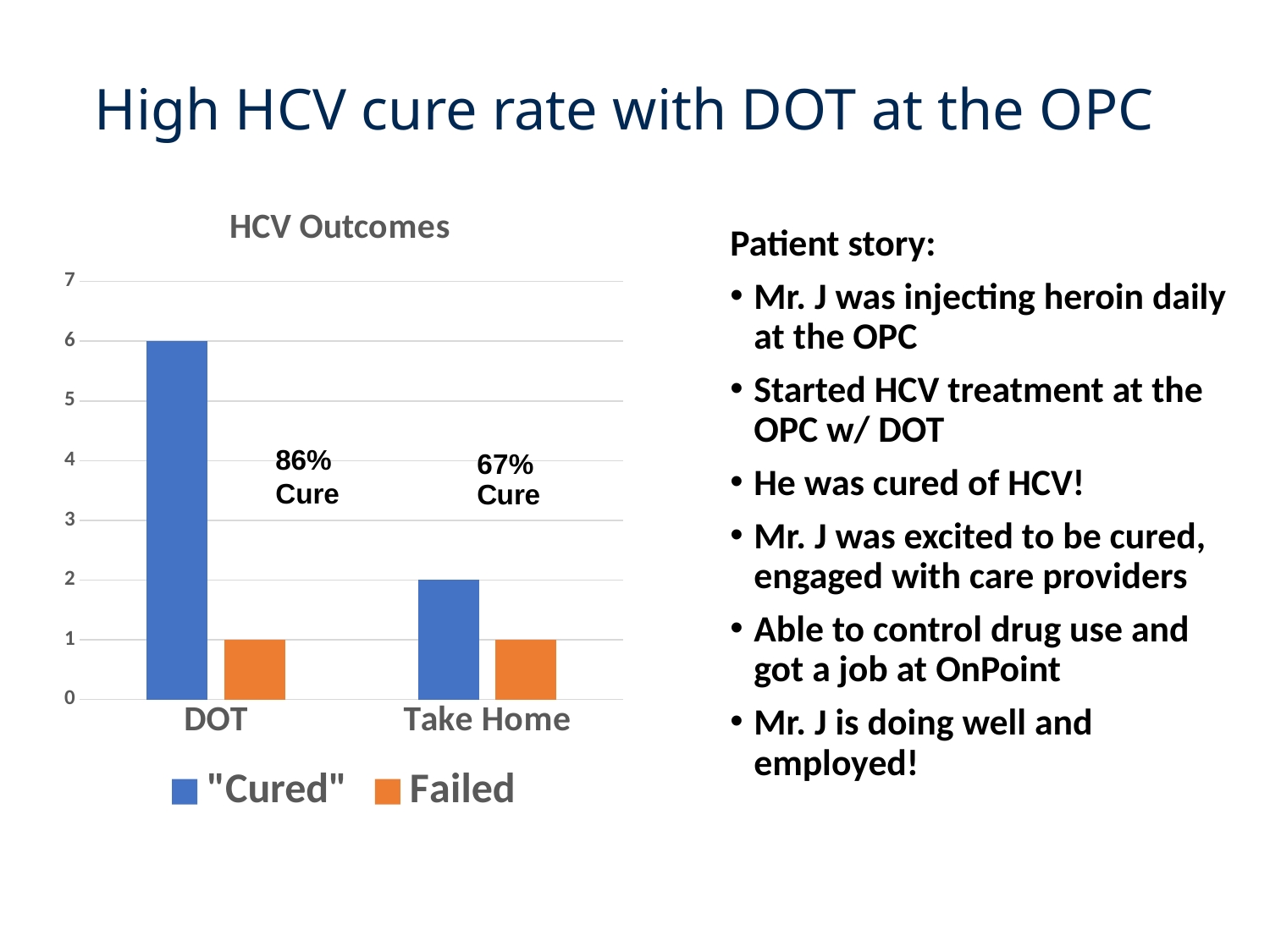
What is the "Cured" value for DOT in the HCV Outcomes chart? 6 What is the difference between the "Cured" values for DOT and Take Home in the HCV Outcomes chart? 4 What colour are the Failed bars in the HCV Outcomes chart? orange What is the Failed value for DOT in the HCV Outcomes chart? 1 What cure percentage is labelled for DOT in the HCV Outcomes chart? 86% How many series does the legend of the HCV Outcomes chart list? 2 Which category has the highest "Cured" value in the HCV Outcomes chart? DOT Is the "Cured" value for DOT greater or less than 5 in the HCV Outcomes chart? greater What is the "Cured" value for Take Home in the HCV Outcomes chart? 2 Is the "Cured" value for DOT larger or smaller than the "Cured" value for Take Home in the HCV Outcomes chart? larger What kind of chart is the HCV Outcomes chart? bar chart How many categories are shown on the x axis of the HCV Outcomes chart? 2